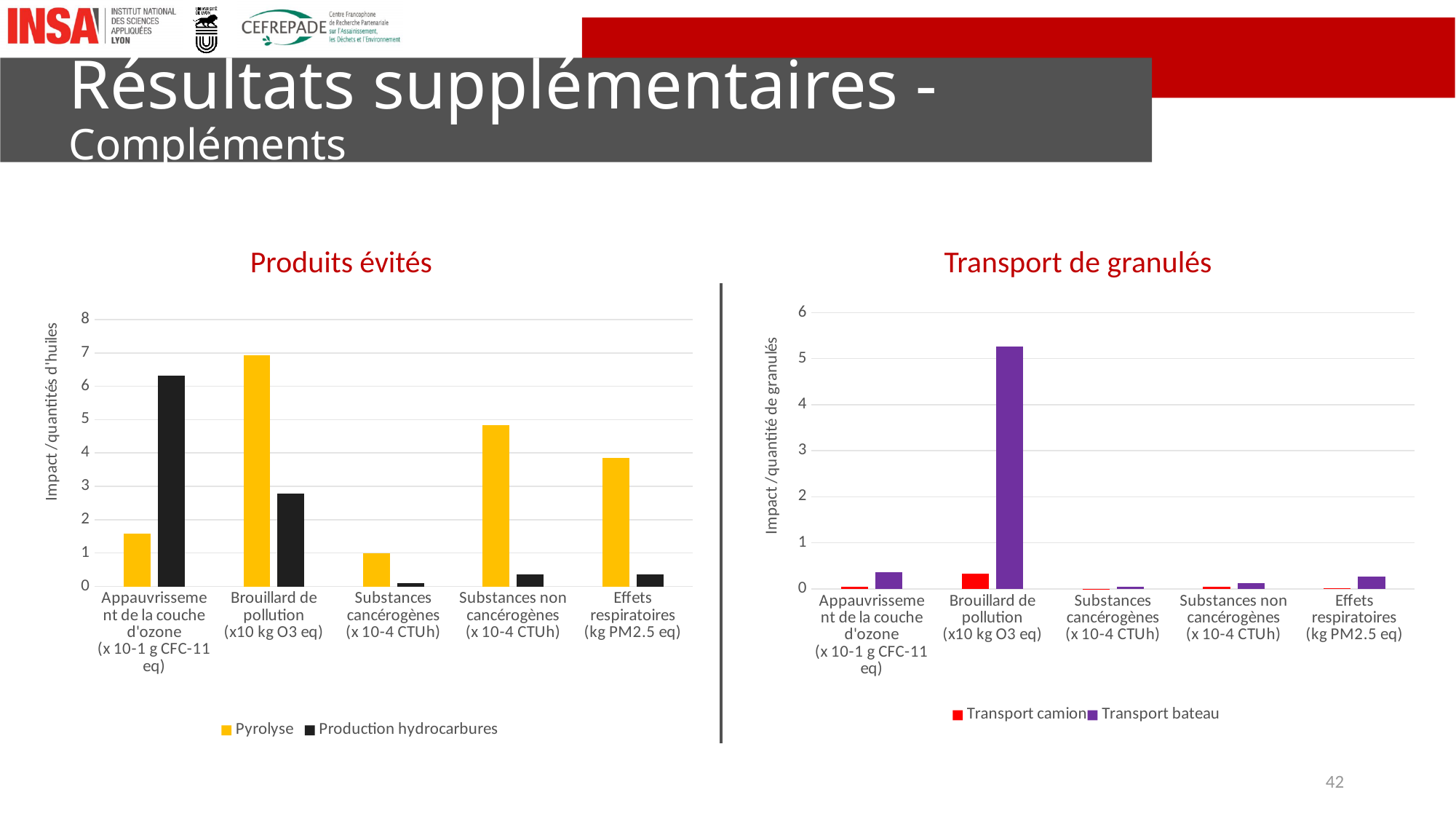
In the 'Produits évités' chart, for Appauvrissement de la couche d'ozone, which series has the larger value: Pyrolyse or Production hydrocarbures? Production hydrocarbures In the 'Transport de granulés' chart, for Brouillard de pollution, which series has the larger value: Transport camion or Transport bateau? Transport bateau In the 'Produits évités' chart, which category has the highest Pyrolyse value? Brouillard de pollution In the 'Produits évités' chart, how many impact categories are shown on the x axis? 5 In the 'Transport de granulés' chart, is the Transport bateau value for Brouillard de pollution greater or less than 4? greater In the 'Produits évités' chart, is the Pyrolyse value for Brouillard de pollution greater or less than 6? greater In the 'Transport de granulés' chart, what colour represents the Transport bateau series? purple In the 'Produits évités' chart, how many series does the legend list? 2 In the 'Produits évités' chart, what kind of chart is shown? bar chart In the 'Produits évités' chart, which category has the lowest Pyrolyse value? Substances cancérogènes In the 'Transport de granulés' chart, which category has the highest Transport bateau value? Brouillard de pollution In the 'Produits évités' chart, which category has the highest Production hydrocarbures value? Appauvrissement de la couche d'ozone